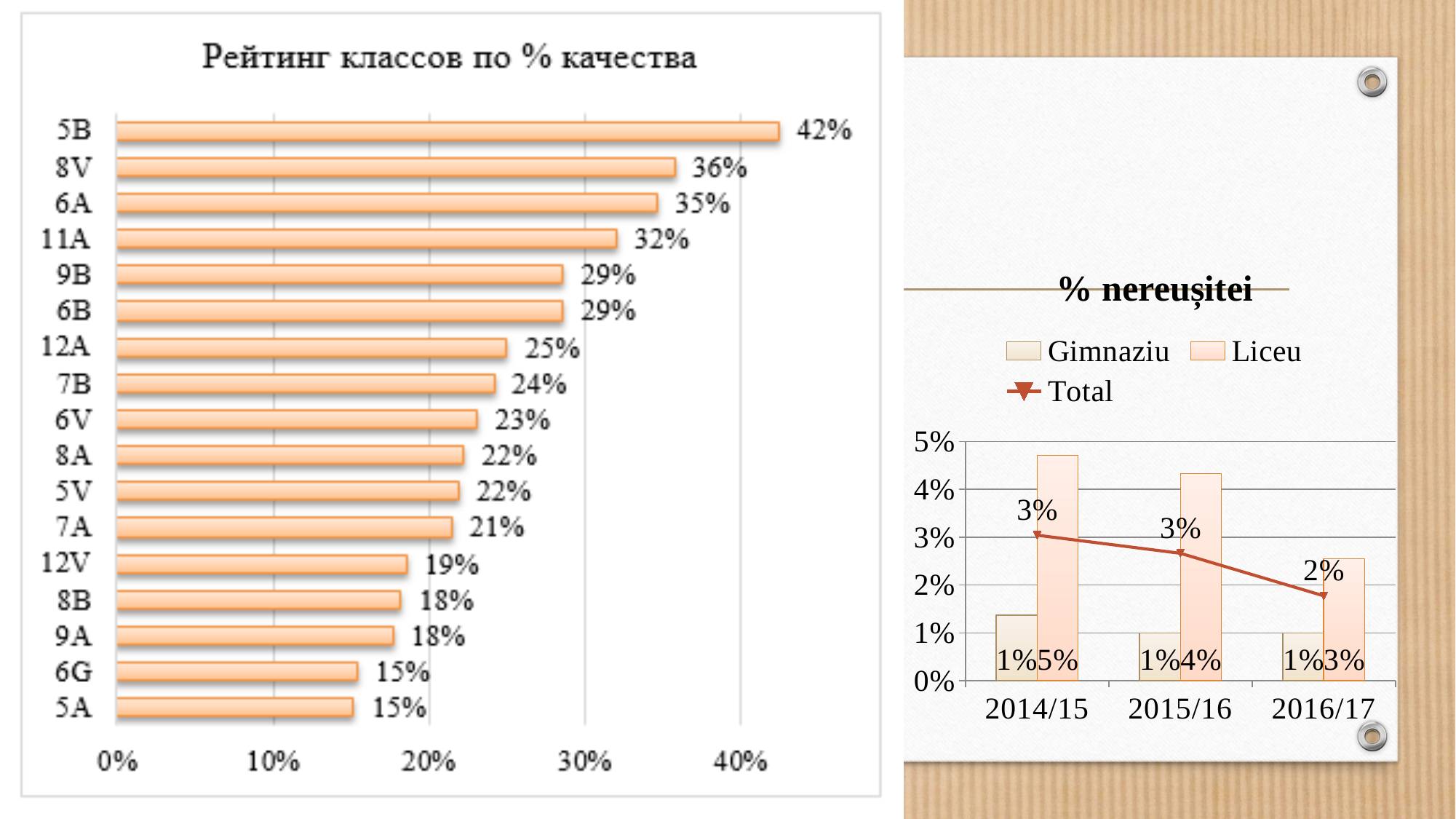
In the chart titled 'Рейтинг классов по % качества', what is the value for class 11A? 32% In the chart titled '% nereușitei', how many series does the legend list? 3 In the chart titled 'Рейтинг классов по % качества', what is the difference between the values for 8V and 6A? 1% In the chart titled 'Рейтинг классов по % качества', what kind of chart is it? bar chart In the chart titled '% nereușitei', what is the Liceu value for 2014/15? 5% In the chart titled '% nereușitei', what is the Total value for 2016/17? 2% In the chart titled 'Рейтинг классов по % качества', what is the value for class 5B? 42% In the chart titled '% nereușitei', do the Liceu values rise or fall from 2014/15 to 2016/17? fall In the chart titled 'Рейтинг классов по % качества', how many classes are shown? 17 In the chart titled '% nereușitei', what is the difference between the Liceu and Gimnaziu values for 2015/16? 3% In the chart titled 'Рейтинг классов по % качества', which has a larger value, 12A or 7B? 12A In the chart titled 'Рейтинг классов по % качества', which class has the highest value? 5B